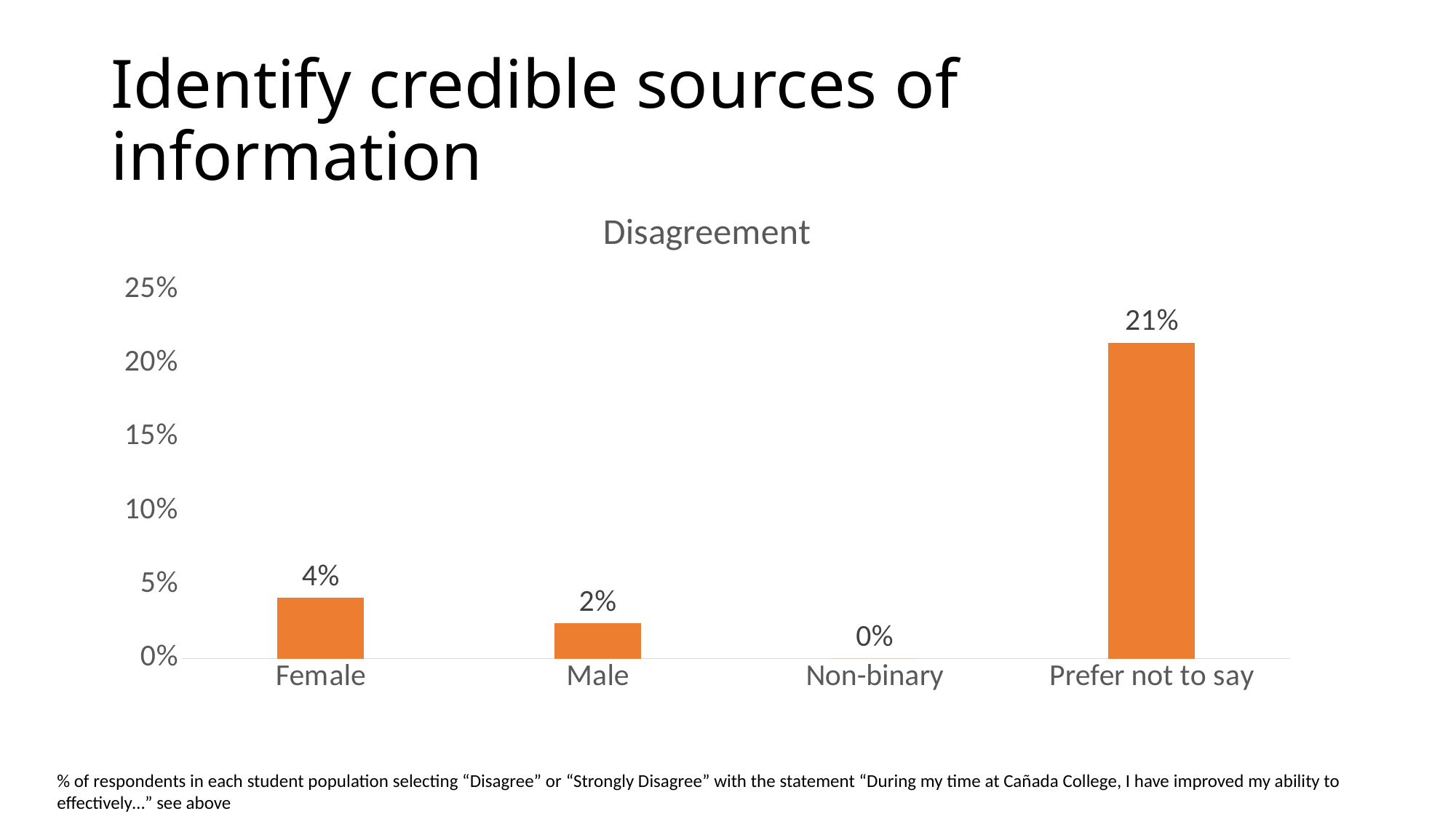
Which category has the highest value? Prefer not to say Which is larger, the value for Female or the value for Male? Female What is the value for Non-binary? 0% What is the difference between the values for Female and Male? 2% Which category has the lowest value? Non-binary What is the value for Female? 4% What is the difference between the values for Prefer not to say and Female? 17% How many categories are shown on the x axis? 4 What is the title of the chart? Disagreement What is the value for Prefer not to say? 21% What is the value for Male? 2% What kind of chart is shown on the slide? Bar chart